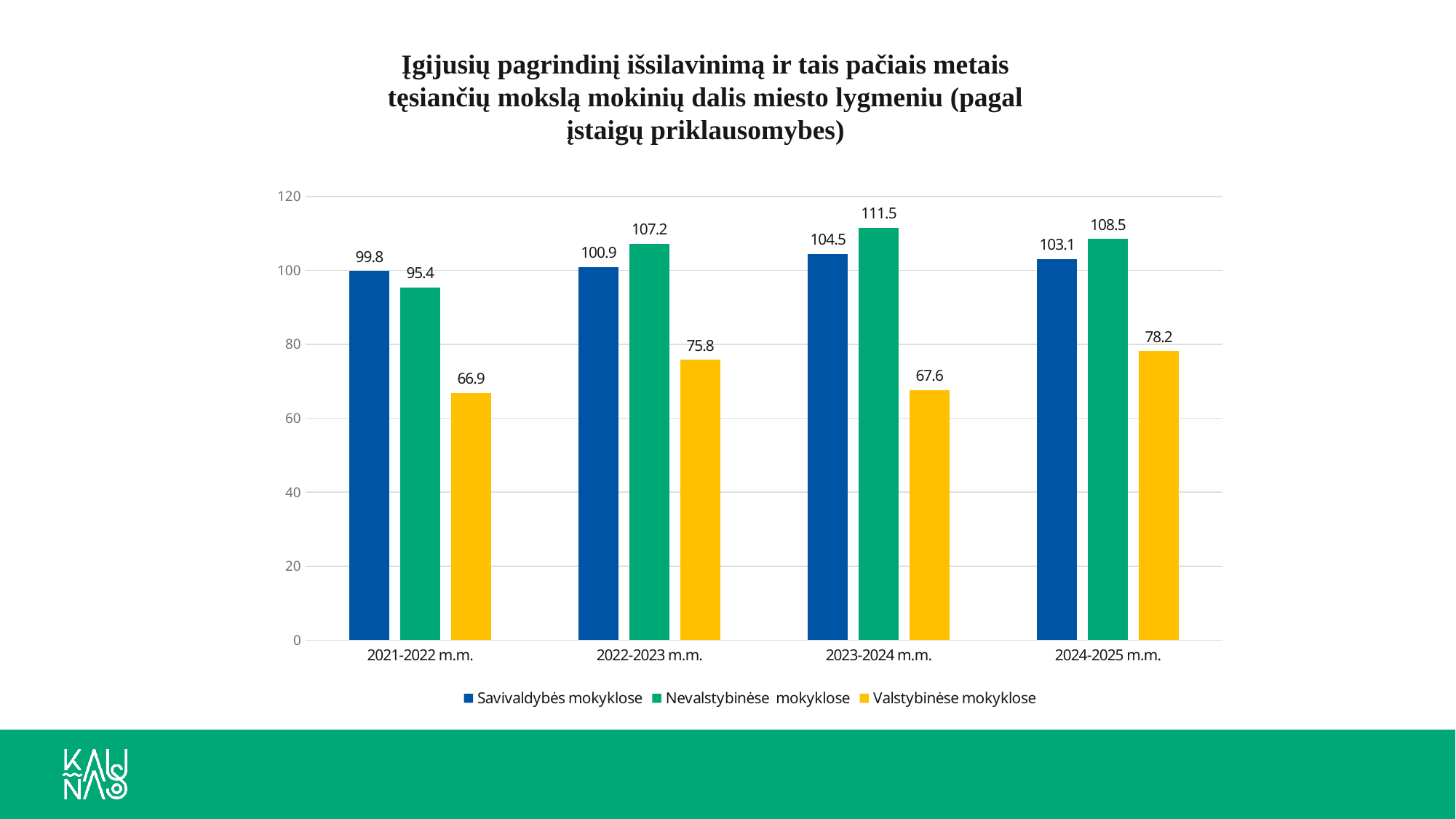
How many series does the legend list? 3 In which school year is the value for Valstybinėse mokyklose lowest? 2021-2022 m.m. What is the value for Nevalstybinėse mokyklose in 2023-2024 m.m.? 111.5 What is the value for Valstybinėse mokyklose in 2024-2025 m.m.? 78.2 Which is larger in 2021-2022 m.m.: Savivaldybės mokyklose or Nevalstybinėse mokyklose? Savivaldybės mokyklose Which colour represents Valstybinėse mokyklose in the chart? yellow What kind of chart is shown on the slide? bar chart What is the value for Savivaldybės mokyklose in 2021-2022 m.m.? 99.8 Is the value for Valstybinėse mokyklose in 2023-2024 m.m. greater or less than 80? less What is the difference between Nevalstybinėse mokyklose and Savivaldybės mokyklose in 2022-2023 m.m.? 6.3 How many school years are shown on the x axis? 4 In which school year is the value for Nevalstybinėse mokyklose highest? 2023-2024 m.m.